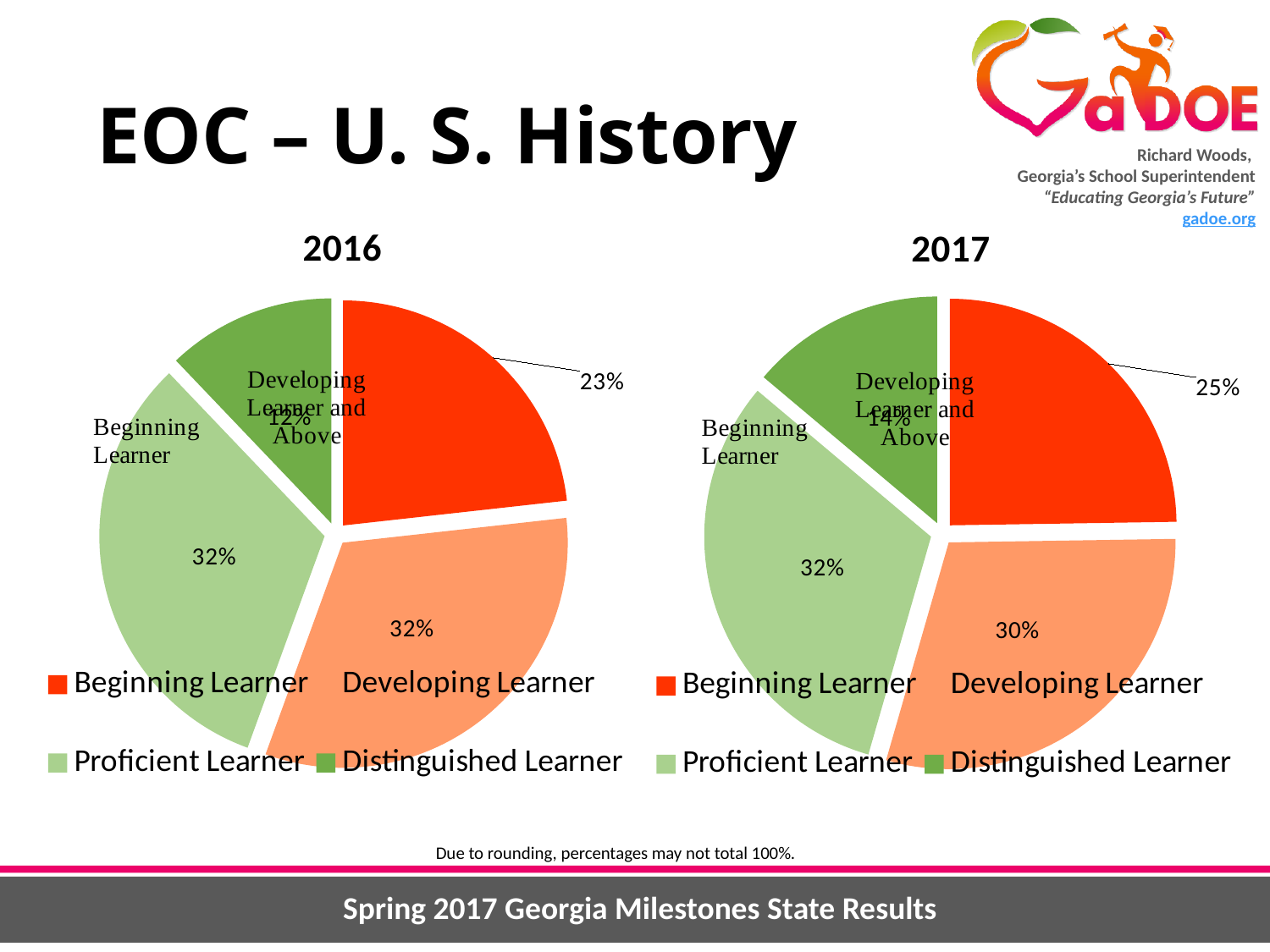
In the 2017 pie chart, what percentage is shown for Distinguished Learner? 14% What type of chart is used on this slide? Pie chart In the 2016 pie chart, what percentage is shown for Beginning Learner? 23% How many categories does each pie chart show? 4 What is the title of the chart on the left? 2016 In the 2016 pie chart, what percentage is shown for Distinguished Learner? 12% In the 2017 pie chart, which category has the smallest share? Distinguished Learner In the 2017 pie chart, which is larger: Beginning Learner or Developing Learner? Developing Learner In the 2017 pie chart, which category has the largest share? Proficient Learner In the 2017 pie chart, what percentage is shown for Developing Learner? 30% What is the difference between the Beginning Learner percentage in 2017 and in 2016? 2% In the 2017 pie chart, what percentage is shown for Beginning Learner? 25%